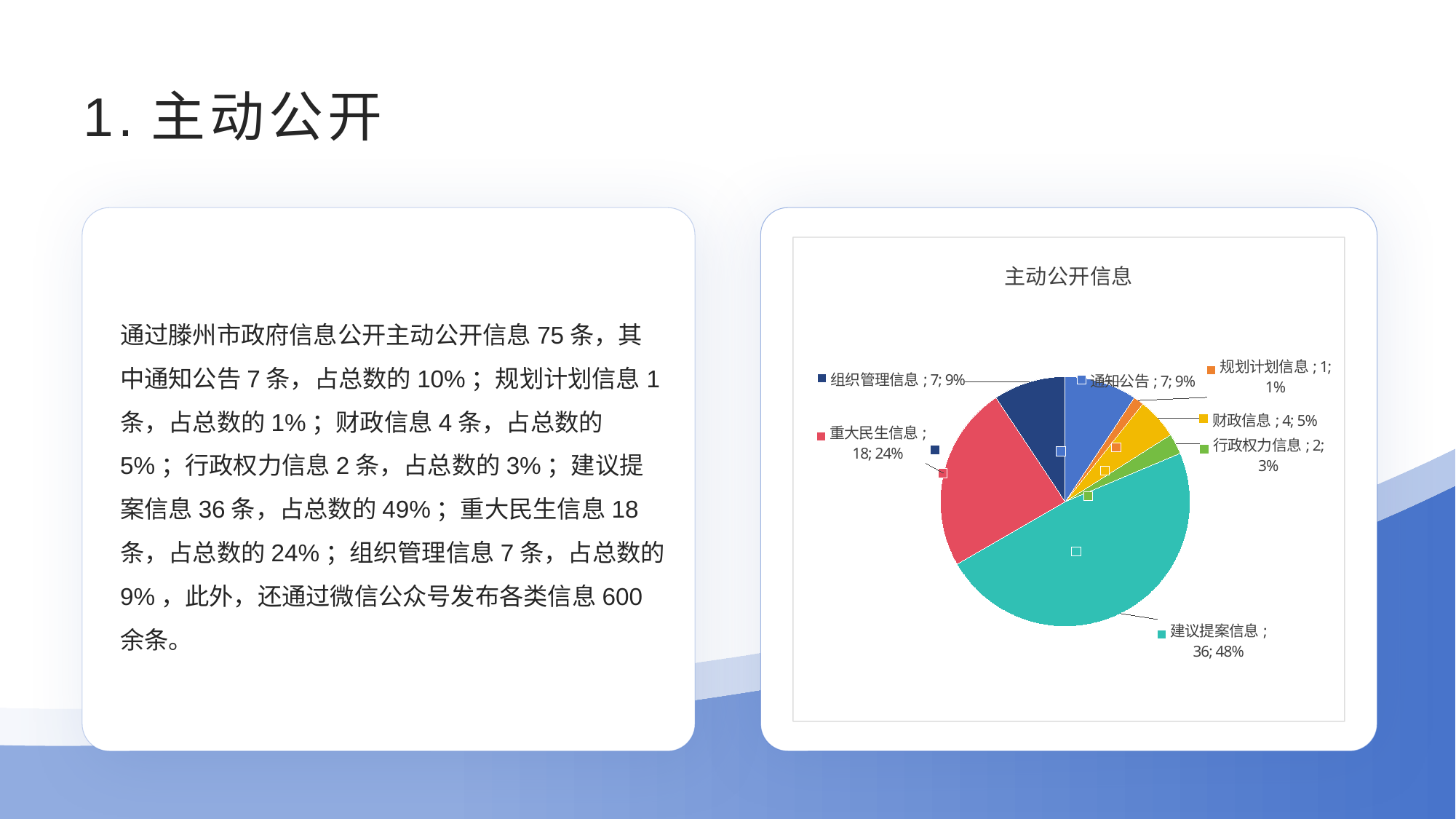
What is the title of the chart? 主动公开信息 What share of the pie does 建议提案信息 represent? 48% Which category has the smallest slice? 规划计划信息 What kind of chart is shown on the slide? pie chart What is the value for 财政信息? 4 What is the value for 重大民生信息? 18 Which category has the largest slice? 建议提案信息 What is the value for 建议提案信息? 36 How many slices does the pie chart have? 7 Which is larger, the value for 财政信息 or the value for 行政权力信息? 财政信息 What is the difference between the values for 建议提案信息 and 重大民生信息? 18 What share of the pie does 重大民生信息 represent? 24%